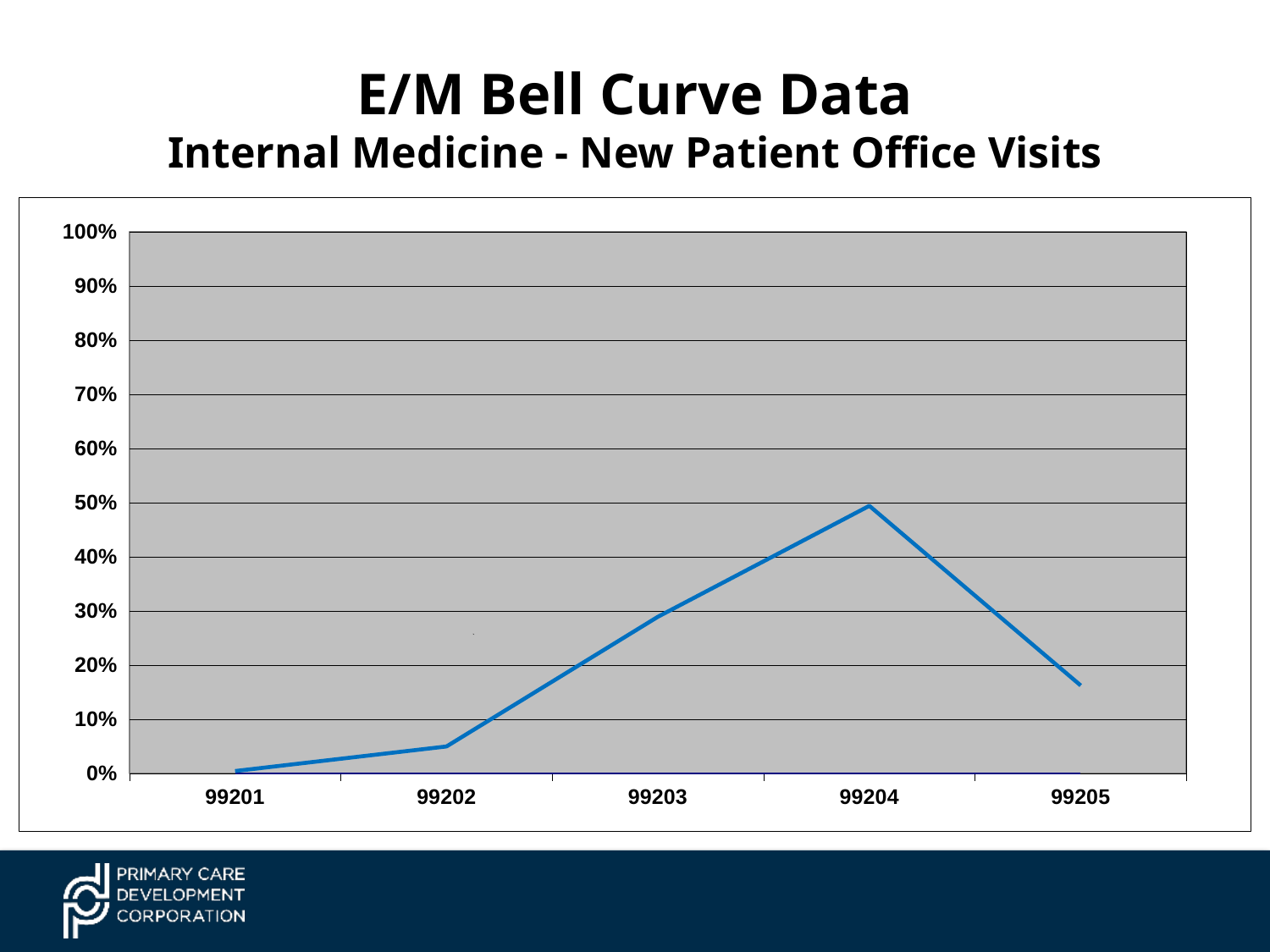
What is the subtitle of the chart shown on the slide? Internal Medicine - New Patient Office Visits Is the value for 99202 greater or less than 10%? less Do the values rise or fall from 99201 to 99204? rise What kind of chart is shown on the slide? line chart Which category has the highest value? 99204 Which category has the lowest value? 99201 How many categories are plotted along the x axis? 5 Which is larger, the value for 99203 or the value for 99205? 99203 Is the value for 99205 greater or less than 20%? less Is the value for 99204 greater or less than 40%? greater Which is larger, the value for 99202 or the value for 99204? 99204